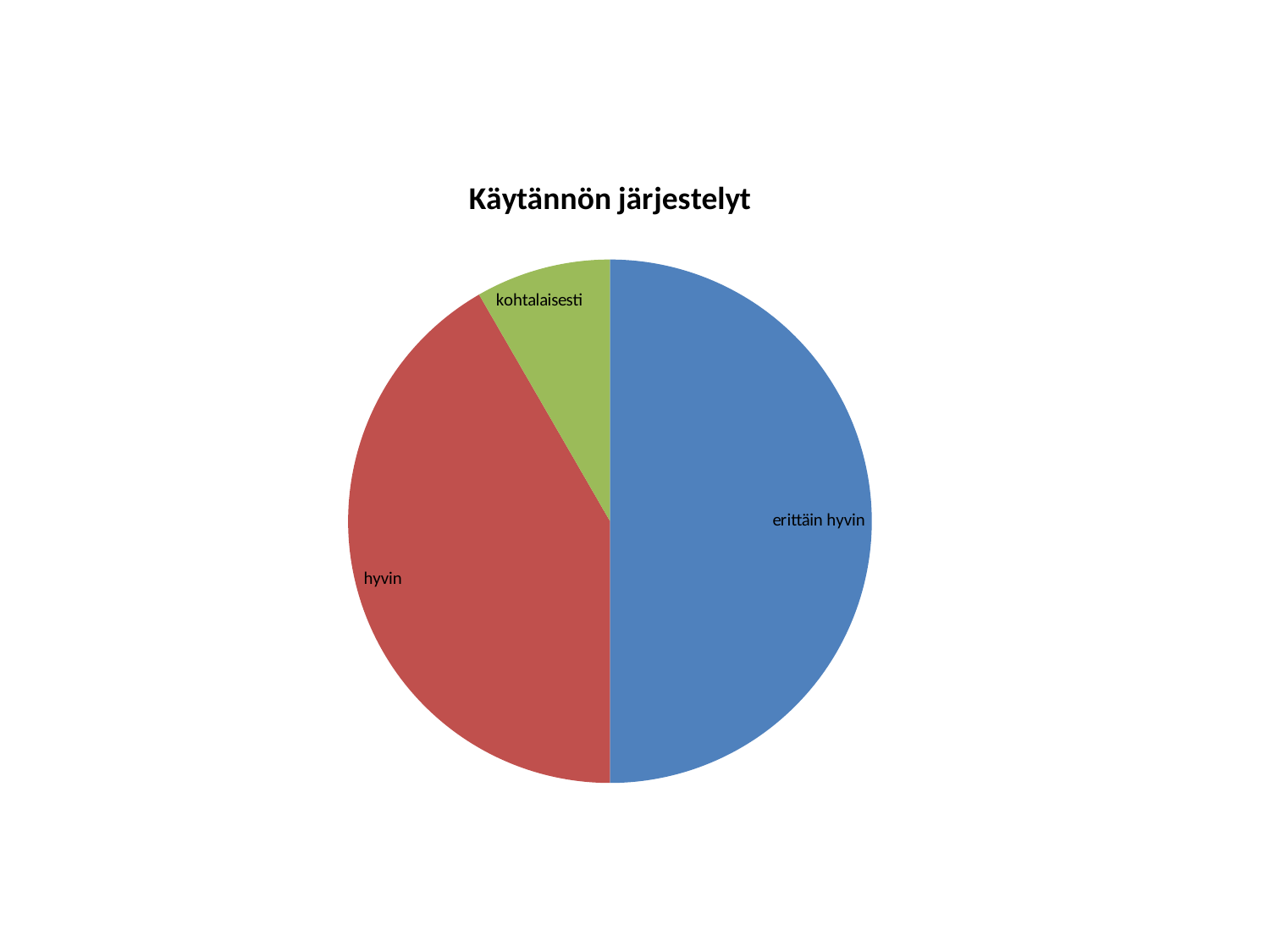
What colour is the slice for hyvin? red Which category has the largest slice of the pie? erittäin hyvin What kind of chart is shown on the slide? pie chart How many slices does the pie chart have? 3 Which category has the smallest slice of the pie? kohtalaisesti Which slice is larger, erittäin hyvin or hyvin? erittäin hyvin What is the title of the chart? Käytännön järjestelyt Which slice is larger, hyvin or kohtalaisesti? hyvin